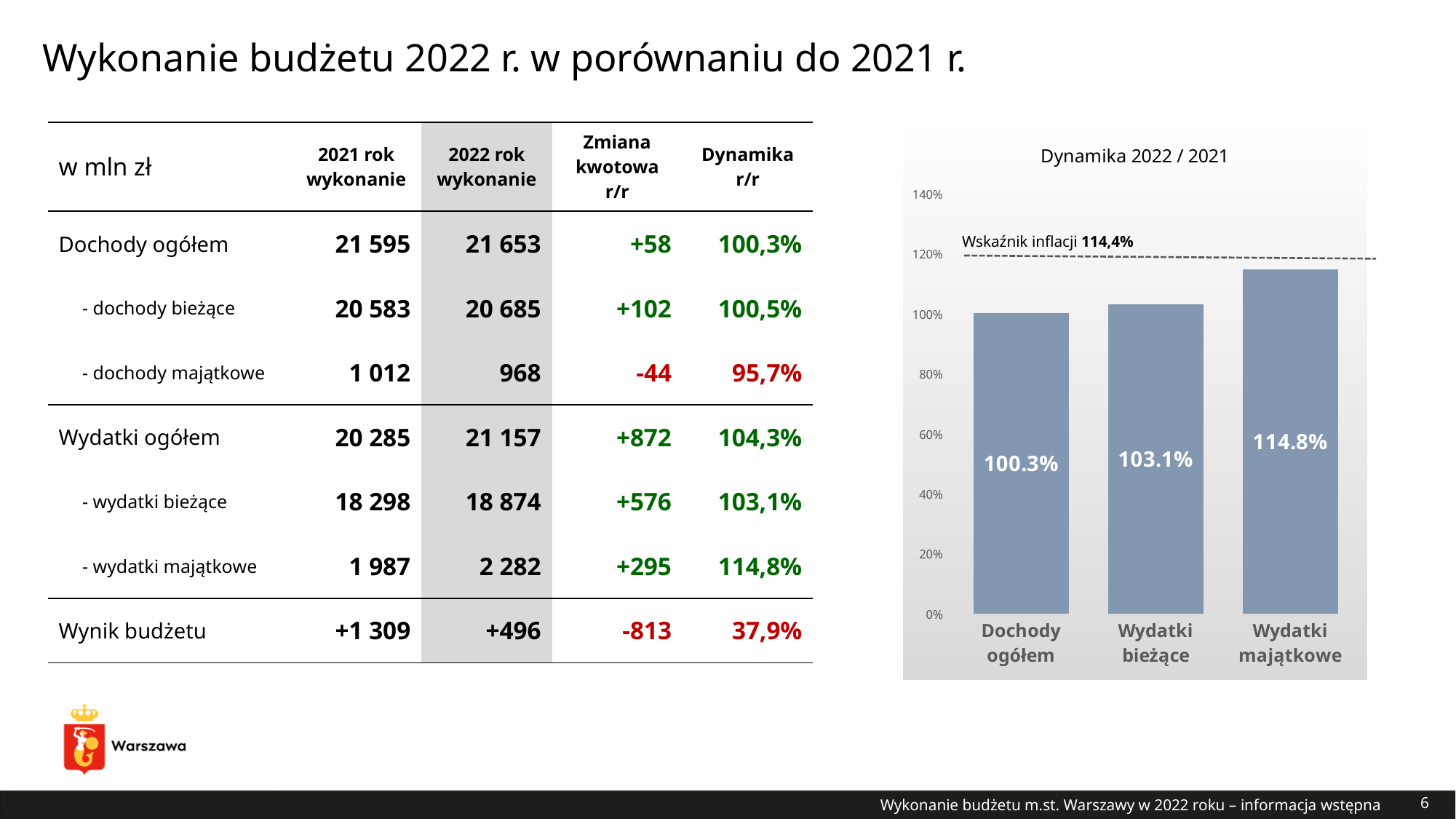
Which is larger in the chart, the value for Wydatki bieżące or the value for Wydatki majątkowe? Wydatki majątkowe Which category has the lowest value in the chart? Dochody ogółem How many categories are plotted in the chart? 3 Do the values rise or fall from left to right across the categories in the chart? rise What inflation rate (Wskaźnik inflacji) is marked by the dashed line in the chart? 114,4% What kind of chart is shown on the slide? bar chart What is the value for Dochody ogółem in the chart? 100.3% What is the difference between the values for Wydatki majątkowe and Dochody ogółem in the chart? 14.5 percentage points What is the value for Wydatki bieżące in the chart? 103.1% What is the title of the chart on the slide? Dynamika 2022 / 2021 What is the value for Wydatki majątkowe in the chart? 114.8% Which category has the highest value in the chart? Wydatki majątkowe